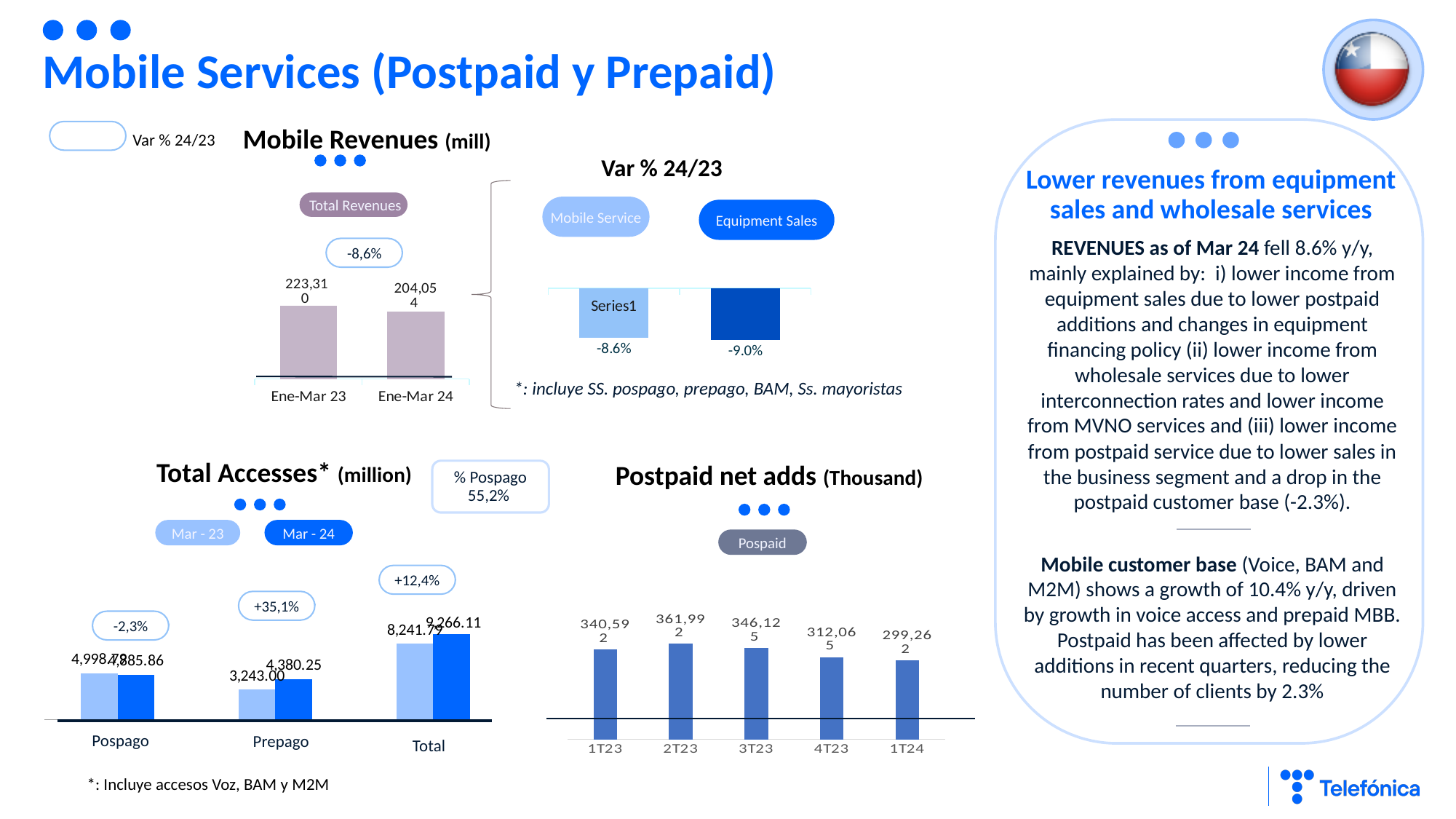
In the Var % 24/23 chart, what is the value for Mobile Service? -8.6% In the Total Accesses chart, what is the Mar - 24 value for Total? 9,266.11 In the Mobile Revenues chart, what is the value for Ene-Mar 23? 223,310 In the Total Accesses chart, what is the Mar - 24 value for Prepago? 4,380.25 In the Var % 24/23 chart, what is the value for Equipment Sales? -9.0% In the Total Accesses chart, what is the Mar - 23 value for Prepago? 3,243.00 In the Postpaid net adds chart, which quarter has the lowest value? 1T24 In the Postpaid net adds chart, how many quarters are shown? 5 In the Total Accesses chart, how many series does the legend list? 2 In the Mobile Revenues chart, which period has the higher value, Ene-Mar 23 or Ene-Mar 24? Ene-Mar 23 In the Mobile Revenues chart, what is the value for Ene-Mar 24? 204,054 In the Postpaid net adds chart, which quarter has the highest value? 2T23